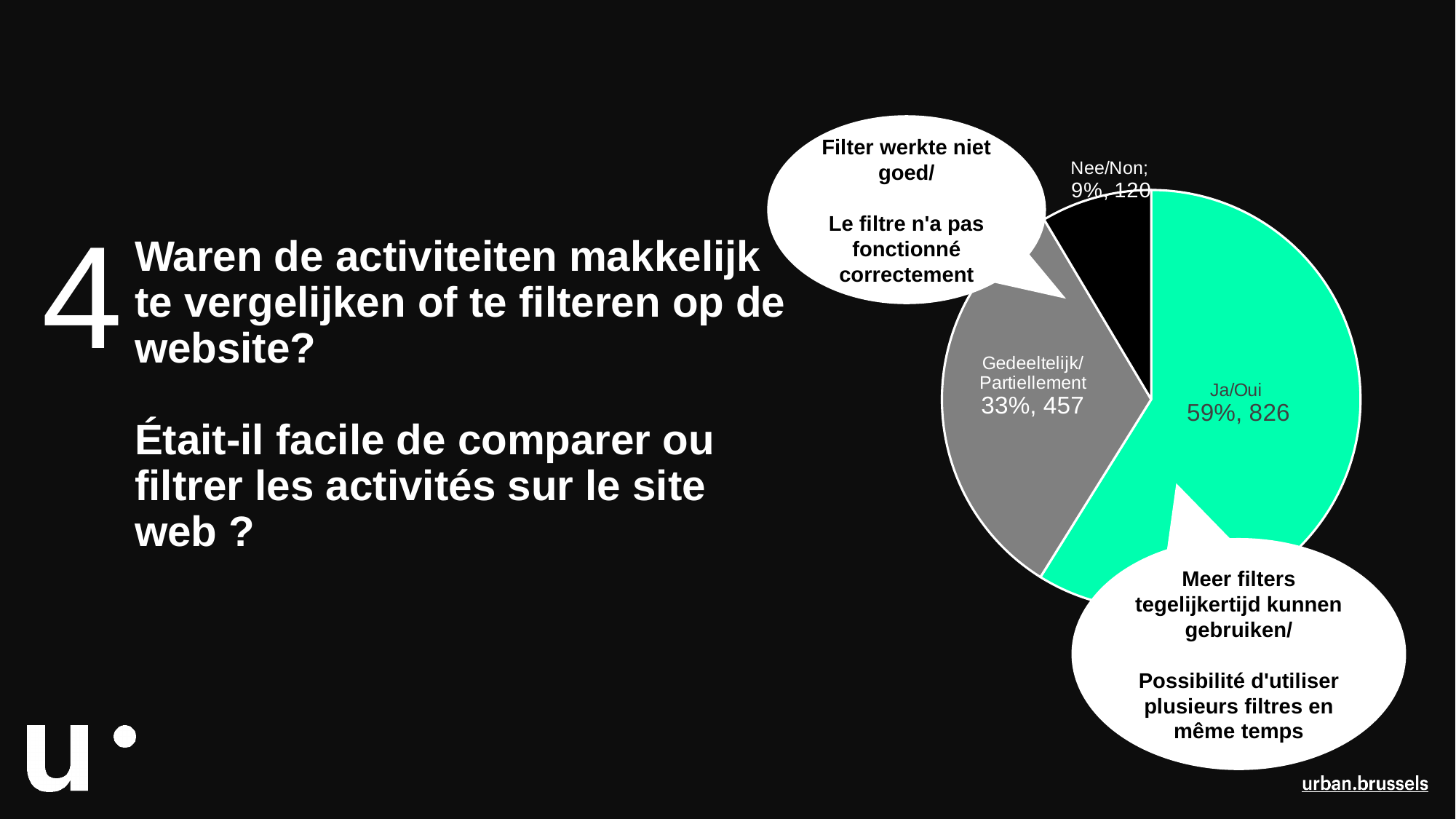
What percentage share does the Gedeeltelijk/Partiellement slice have? 33% What count is shown for the Gedeeltelijk/Partiellement slice? 457 What count is shown for the Nee/Non slice? 120 What percentage share does the Ja/Oui slice have? 59% Which slice of the pie chart is the smallest? Nee/Non What colour is the Ja/Oui slice of the pie chart? green What count is shown for the Ja/Oui slice? 826 Which slice of the pie chart is the largest? Ja/Oui What kind of chart is shown on the slide? pie chart How many slices does the pie chart have? 3 Which slice has a larger count, Gedeeltelijk/Partiellement or Nee/Non? Gedeeltelijk/Partiellement What is the difference in count between the Ja/Oui and Gedeeltelijk/Partiellement slices? 369